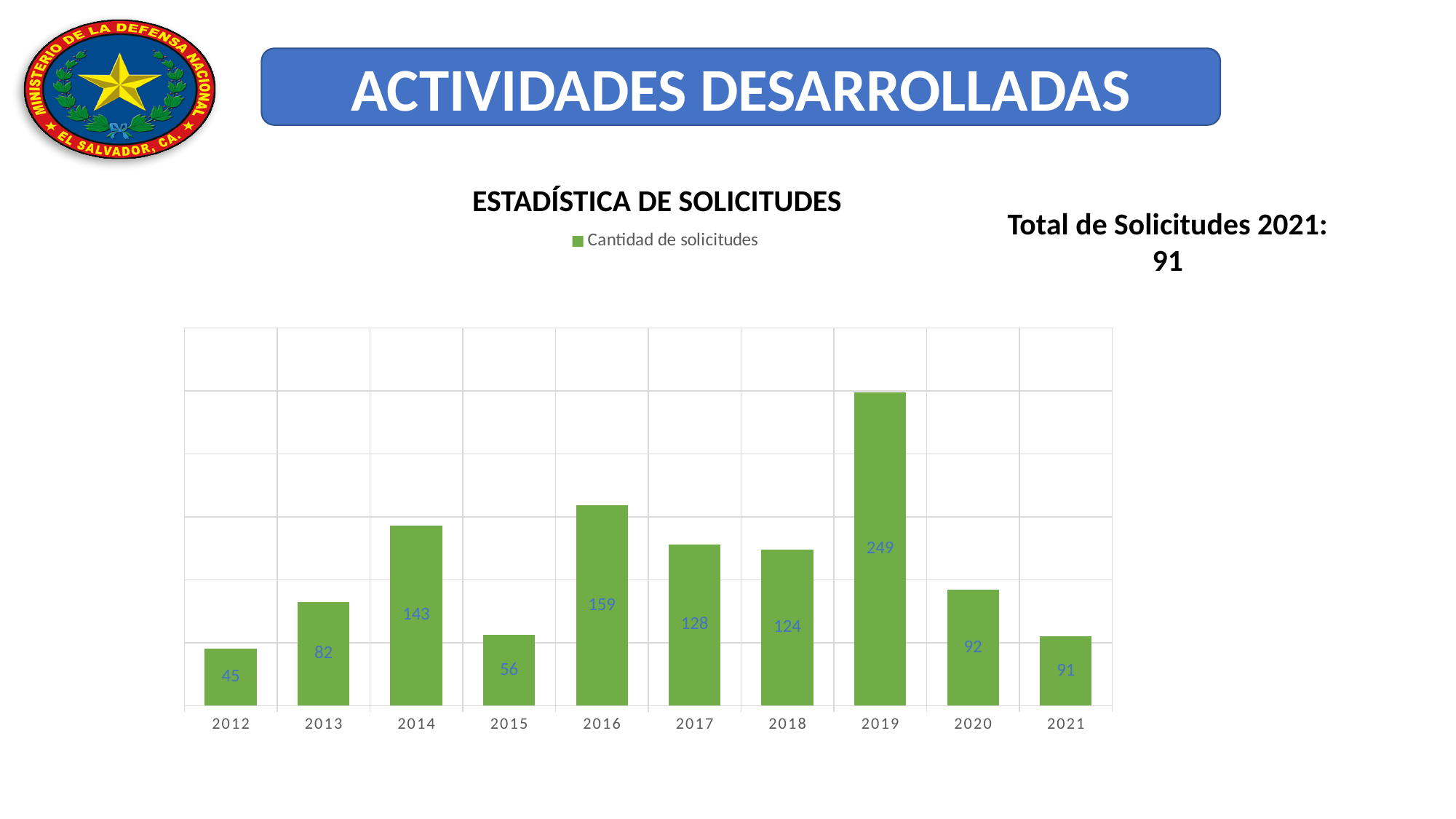
What is the value for 2014? 143 Which is larger, the value for 2017 or the value for 2018? 2017 Which year has the lowest number of solicitudes? 2012 What is the value for 2021? 91 What is the title of the chart? ESTADÍSTICA DE SOLICITUDES What is the difference between the values for 2016 and 2015? 103 Which year has the highest number of solicitudes? 2019 What is the value for 2019? 249 What is the difference between the values for 2019 and 2020? 157 What kind of chart is shown? bar chart How many years are shown on the x axis? 10 How many series does the legend list? 1